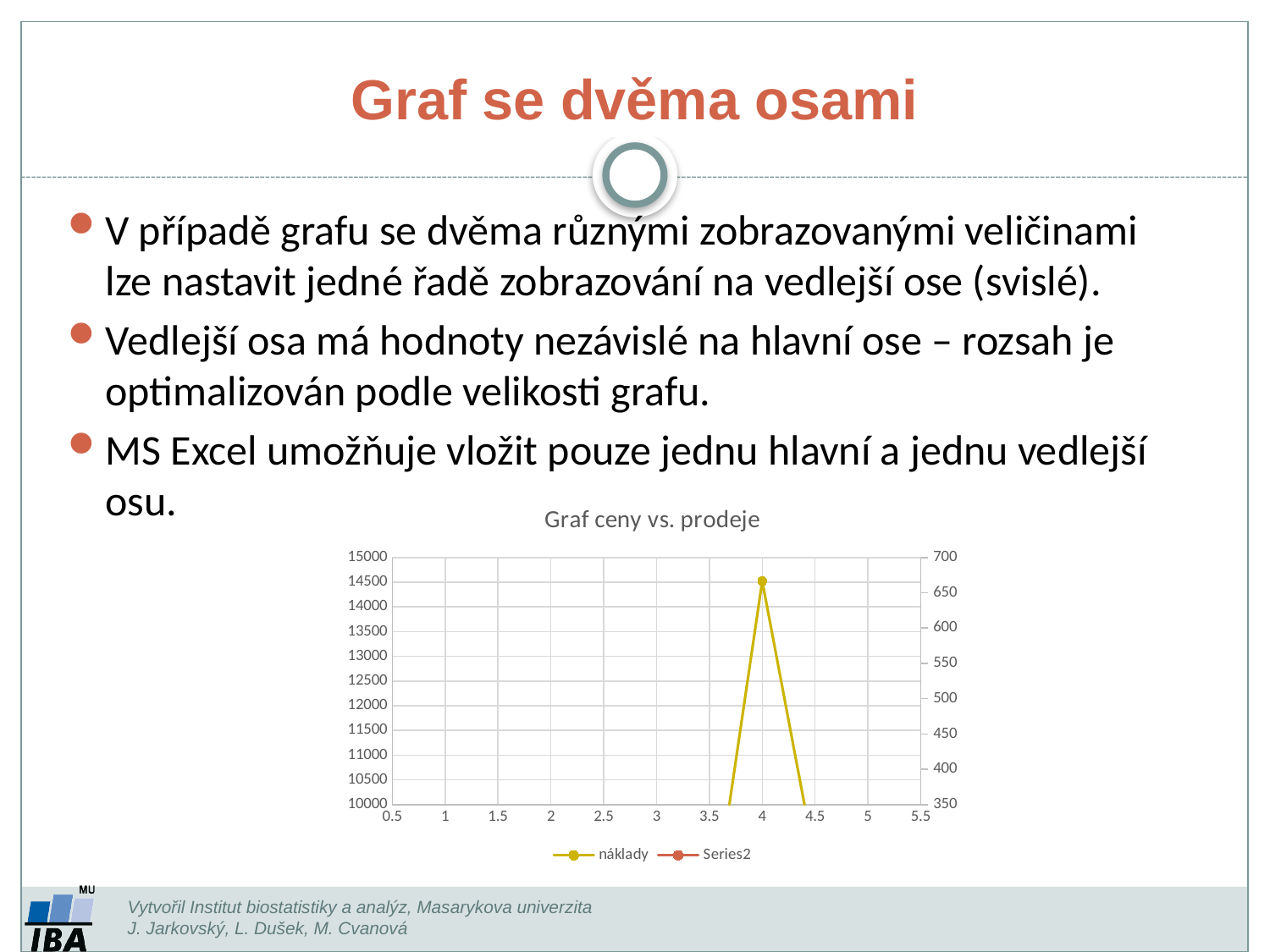
What kind of chart is shown on the slide? line chart How many data point markers are visible on the plotted line? 1 What are the names of the series listed in the chart legend? náklady, Series2 How many series does the chart legend list? 2 At which x value does the náklady series reach its peak? 4 What is the maximum value shown on the right (secondary) vertical axis? 700 Is the value of the náklady series at x = 4 greater or less than 14000 on the left axis? greater What is the minimum value shown on the right (secondary) vertical axis? 350